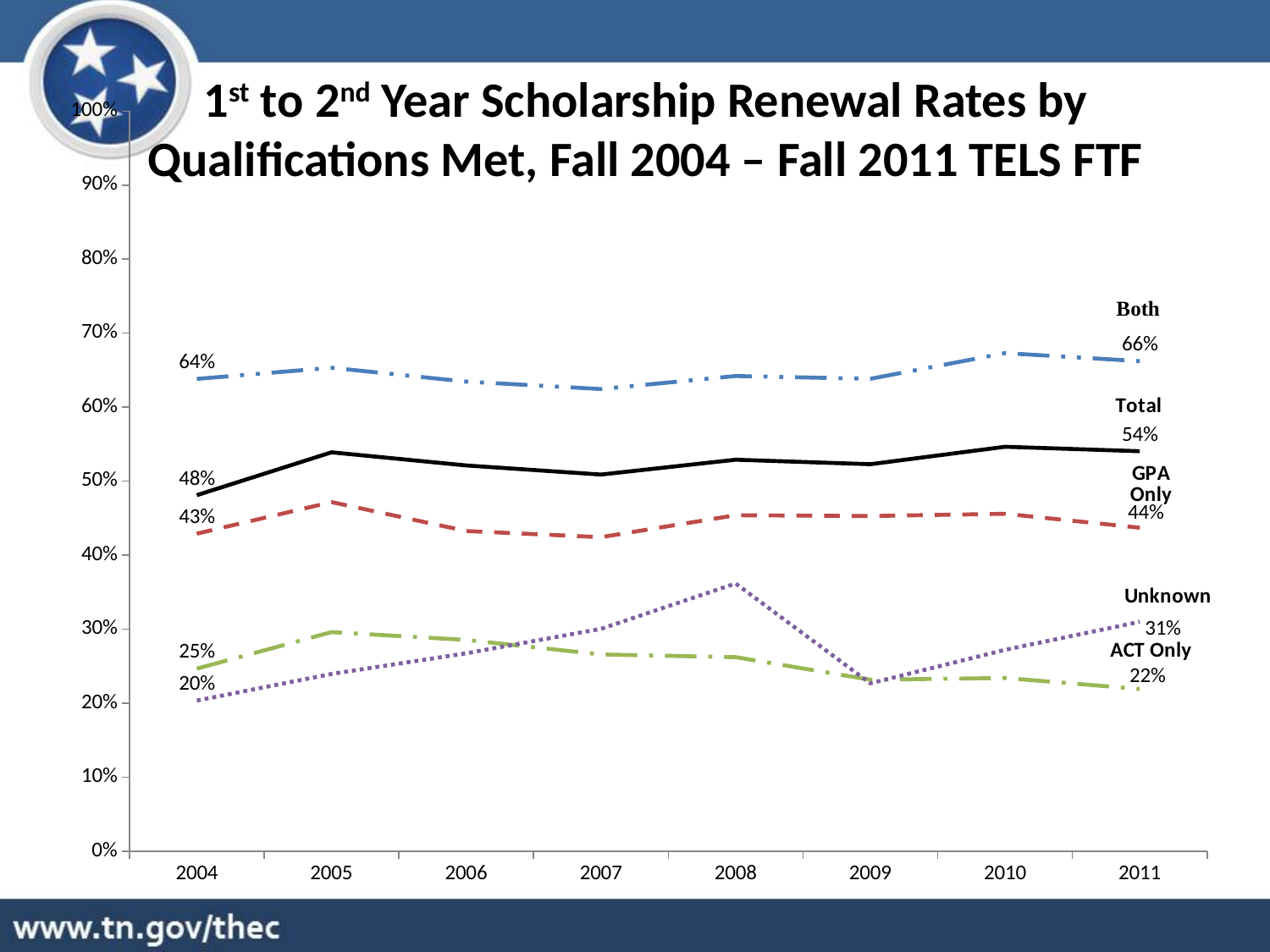
What was the renewal rate for the Both series in 2004? 64% What was the renewal rate for the ACT Only series in 2004? 25% Is the Both series value in 2010 greater or less than 60%? greater What kind of chart is shown on the slide? line chart By how many percentage points did the Total renewal rate change from 2004 (48%) to 2011 (54%)? 6 percentage points What was the renewal rate for the GPA Only series in 2004? 43% What was the renewal rate for the Unknown series in 2011? 31% Which series had the lowest renewal rate in 2004? Unknown Which was larger in 2011, the ACT Only rate or the Unknown rate? Unknown How many years are plotted along the x axis? 8 Which series had the highest renewal rate in 2011? Both What was the renewal rate for the Total series in 2011? 54%